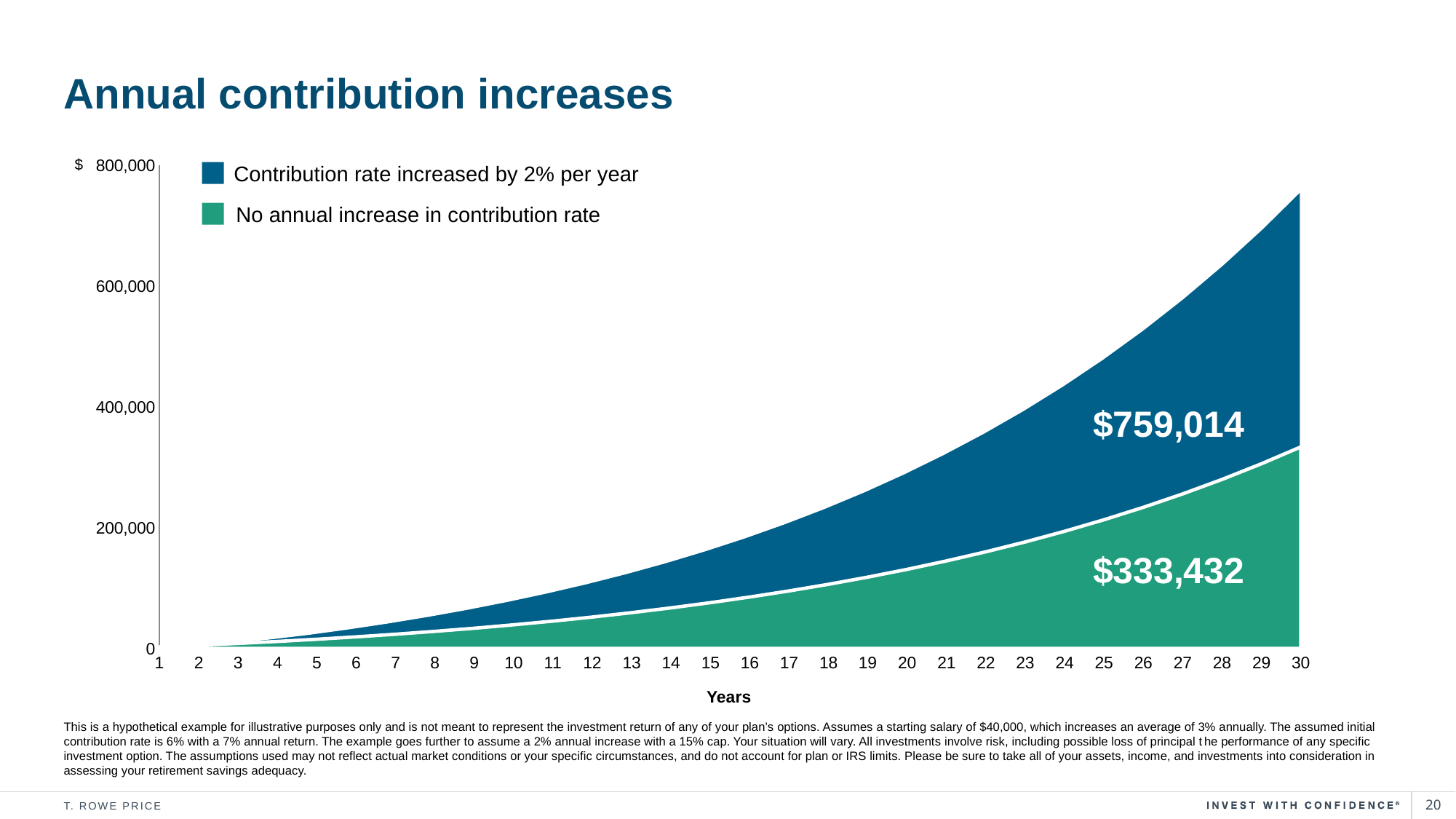
What kind of chart is shown on the slide? Area chart Is the value for 'No annual increase in contribution rate' at year 30 greater or less than 400,000? less What is the value at year 30 for the 'No annual increase in contribution rate' series? $333,432 Do the values rise or fall as the years increase along the x axis? Rise Which series has the higher value at year 30? Contribution rate increased by 2% per year What is the value at year 30 for the 'Contribution rate increased by 2% per year' series? $759,014 What is the label of the x axis? Years How many series does the legend list? 2 What is the difference between the two series' values at year 30? $425,582 Is the value for 'Contribution rate increased by 2% per year' at year 30 greater or less than 600,000? greater How many years are shown on the x axis? 30 Is the value for 'No annual increase in contribution rate' at year 20 greater or less than 200,000? less